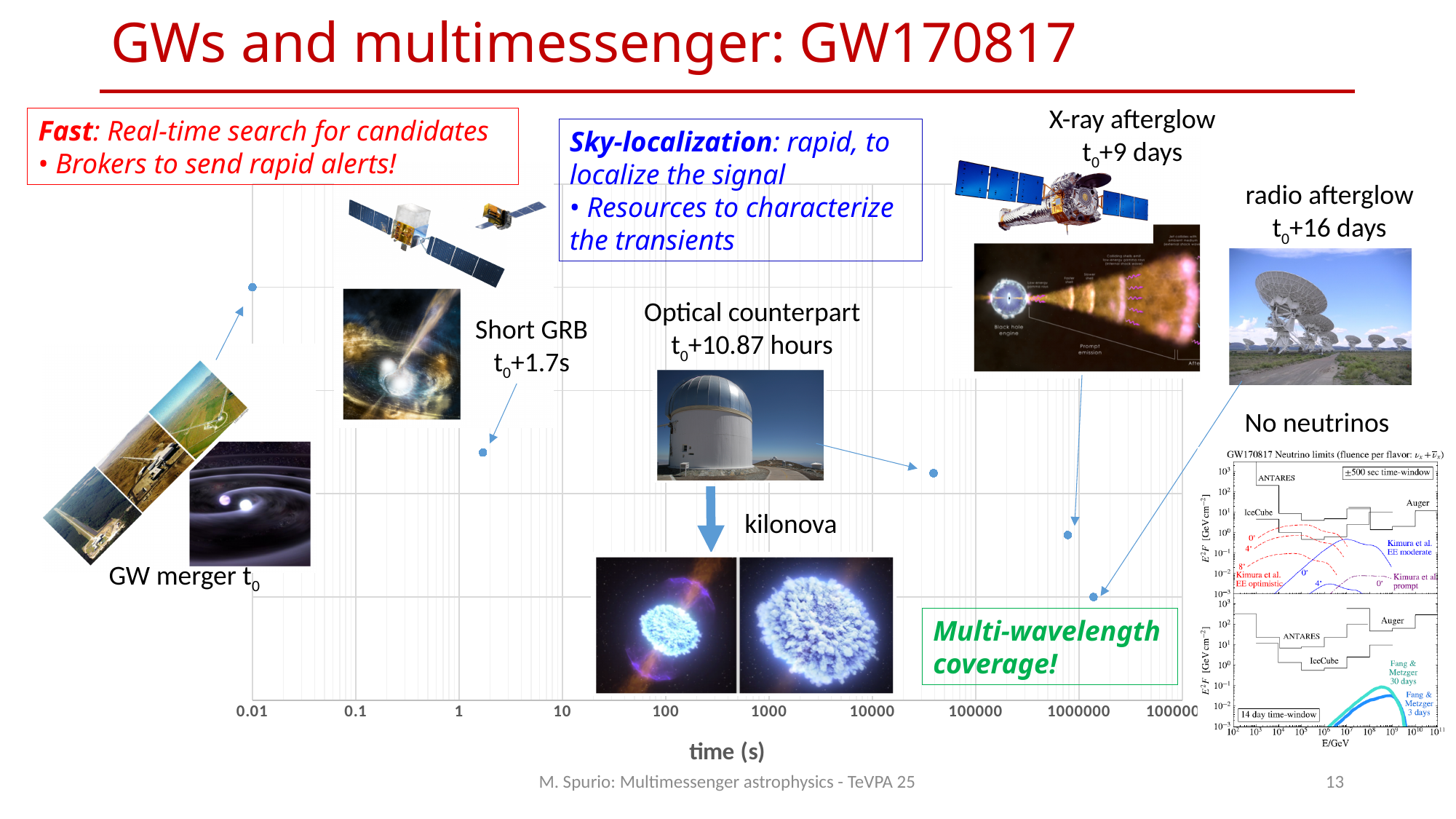
On the timeline chart, how long after t0 was the radio afterglow detected? 16 days On the timeline chart, how long after the GW merger (t0) was the short GRB detected? 1.7 s On the timeline chart, is the time of the optical counterpart point greater or less than 10000 s? greater On the timeline chart, how long after t0 was the optical counterpart detected? 10.87 hours On the timeline chart, how many days separate the X-ray afterglow (t0+9 days) and the radio afterglow (t0+16 days)? 7 days What is the label of the x axis on the timeline chart? time (s) On the timeline chart, which labelled event occurs earliest in time? GW merger t0 In the inset neutrino limits plot, what time window is used for the bottom panel? 14 day time-window On the timeline chart, how long after t0 was the X-ray afterglow detected? 9 days On the timeline chart, which labelled event occurs latest in time? radio afterglow On the timeline chart, is the time of the radio afterglow point greater or less than 1000000 s? greater On the timeline chart, which was detected later, the X-ray afterglow or the radio afterglow? radio afterglow